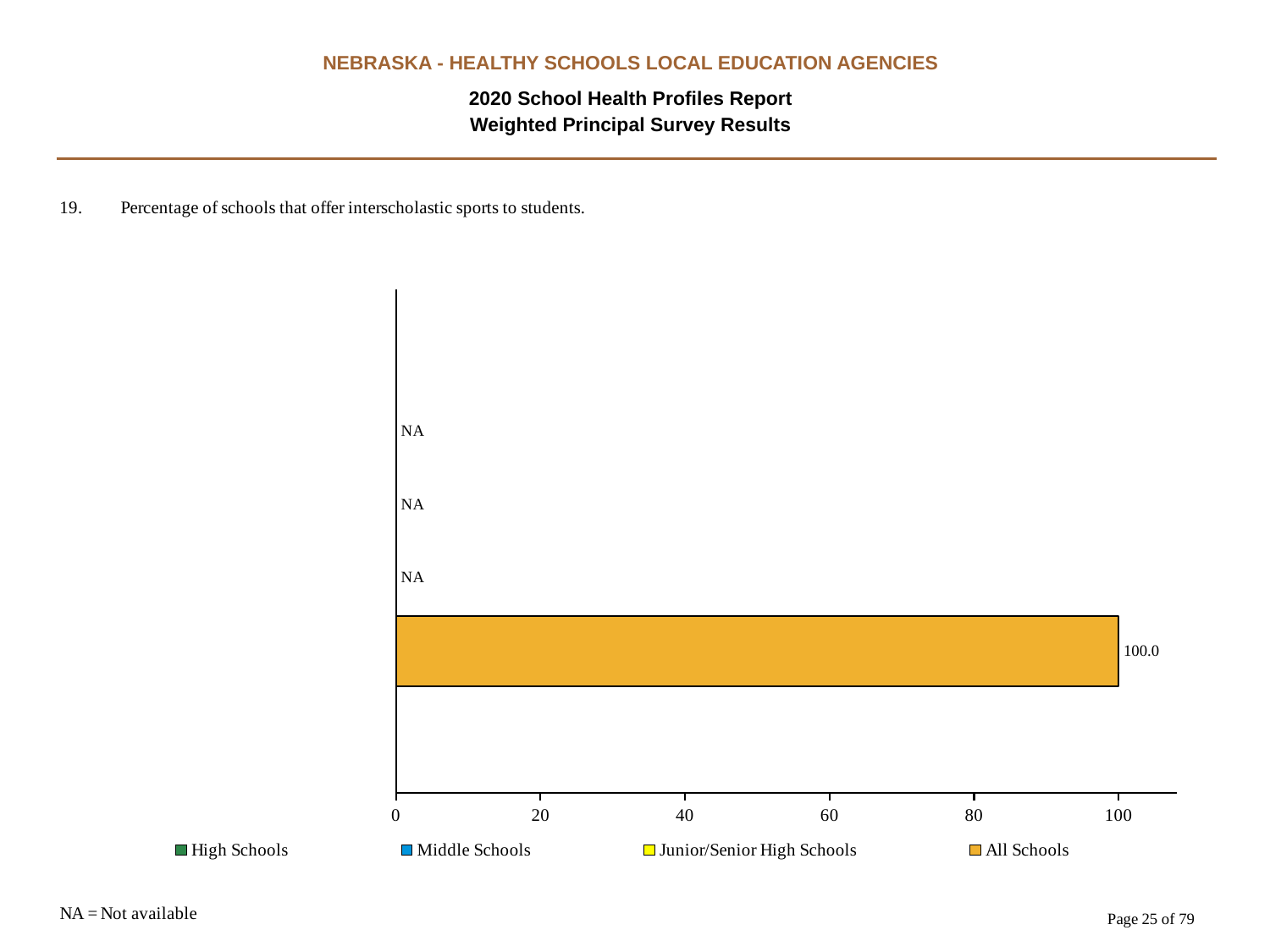
What does NA stand for according to the note on the slide? Not available What value is shown for Middle Schools? NA What value is shown for Junior/Senior High Schools? NA How many series are marked NA on the chart? 3 Is the value for All Schools greater or less than 80? greater Which series has the highest plotted value? All Schools How many series does the legend list? 4 What is the highest value shown on the x axis? 100 What value is shown for High Schools? NA What kind of chart is shown on the slide? Bar chart What is the value for All Schools? 100.0